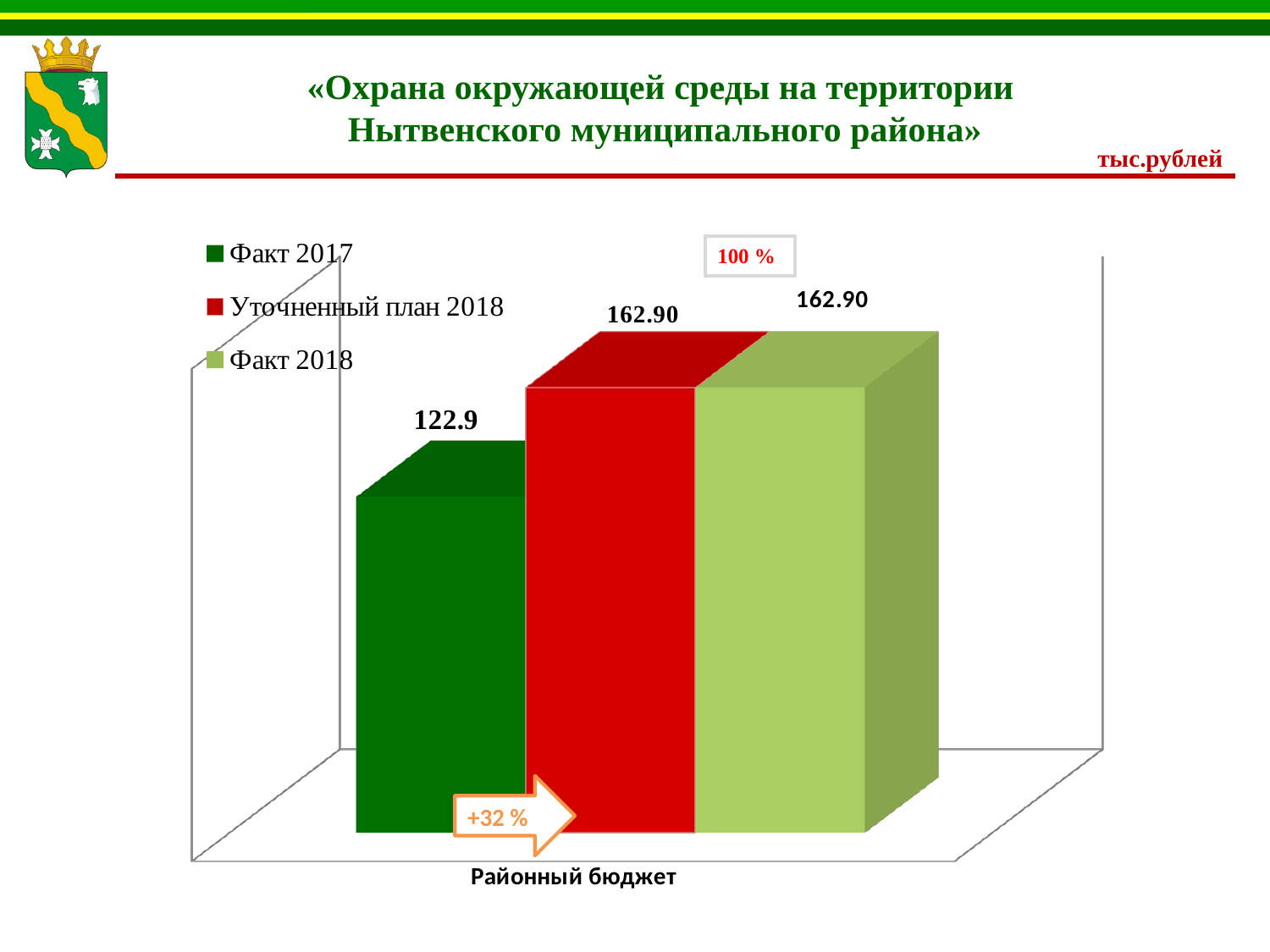
Which series has the lowest value? Факт 2017 Which is larger, Факт 2017 or Уточненный план 2018? Уточненный план 2018 What is the value for Уточненный план 2018? 162.90 What unit of measurement is indicated on the slide? тыс.рублей What is the value for Факт 2018? 162.90 What is the difference between Факт 2018 and Факт 2017? 40.0 How many series does the legend list? 3 How many categories are shown on the x axis? 1 What kind of chart is shown on the slide? bar chart What is the value for Факт 2017 in the Районный бюджет category? 122.9 What is the name of the category on the x axis? Районный бюджет What percentage change is shown in the arrow between Факт 2017 and 2018? +32 %